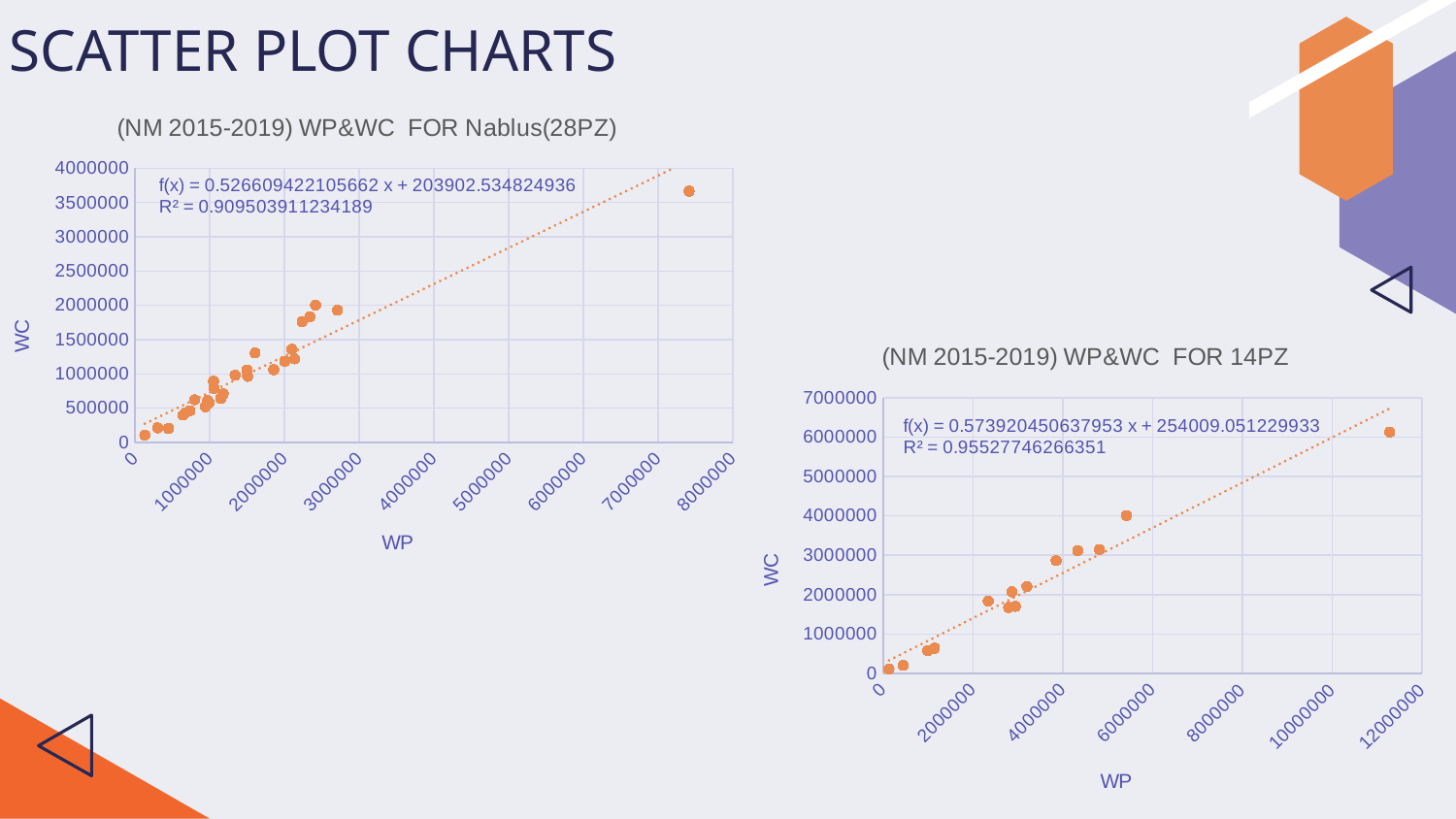
In the chart titled "(NM 2015-2019) WP&WC FOR 14PZ", is the WC value of the point with the highest WP greater or less than 5000000? greater In the chart titled "(NM 2015-2019) WP&WC FOR 14PZ", do the WC values generally rise or fall as WP increases? rise In the chart titled "(NM 2015-2019) WP&WC FOR Nablus(28PZ)", what is the label on the horizontal axis? WP In the chart titled "(NM 2015-2019) WP&WC FOR Nablus(28PZ)", is the WC value of the point with the highest WP greater or less than 3500000? greater What kind of chart is the chart titled "(NM 2015-2019) WP&WC FOR 14PZ"? scatter plot What kind of chart is the chart titled "(NM 2015-2019) WP&WC FOR Nablus(28PZ)"? scatter plot In the chart titled "(NM 2015-2019) WP&WC FOR Nablus(28PZ)", what is the trendline equation printed on the chart? f(x) = 0.526609422105662 x + 203902.534824936 In the chart titled "(NM 2015-2019) WP&WC FOR 14PZ", what is the R² value printed on the chart? R² = 0.95527746266351 In the chart titled "(NM 2015-2019) WP&WC FOR Nablus(28PZ)", do the WC values generally rise or fall as WP increases? rise In the chart titled "(NM 2015-2019) WP&WC FOR 14PZ", what is the label on the vertical axis? WC In the chart titled "(NM 2015-2019) WP&WC FOR Nablus(28PZ)", what is the R² value printed on the chart? R² = 0.909503911234189 In the chart titled "(NM 2015-2019) WP&WC FOR 14PZ", what is the trendline equation printed on the chart? f(x) = 0.573920450637953 x + 254009.051229933